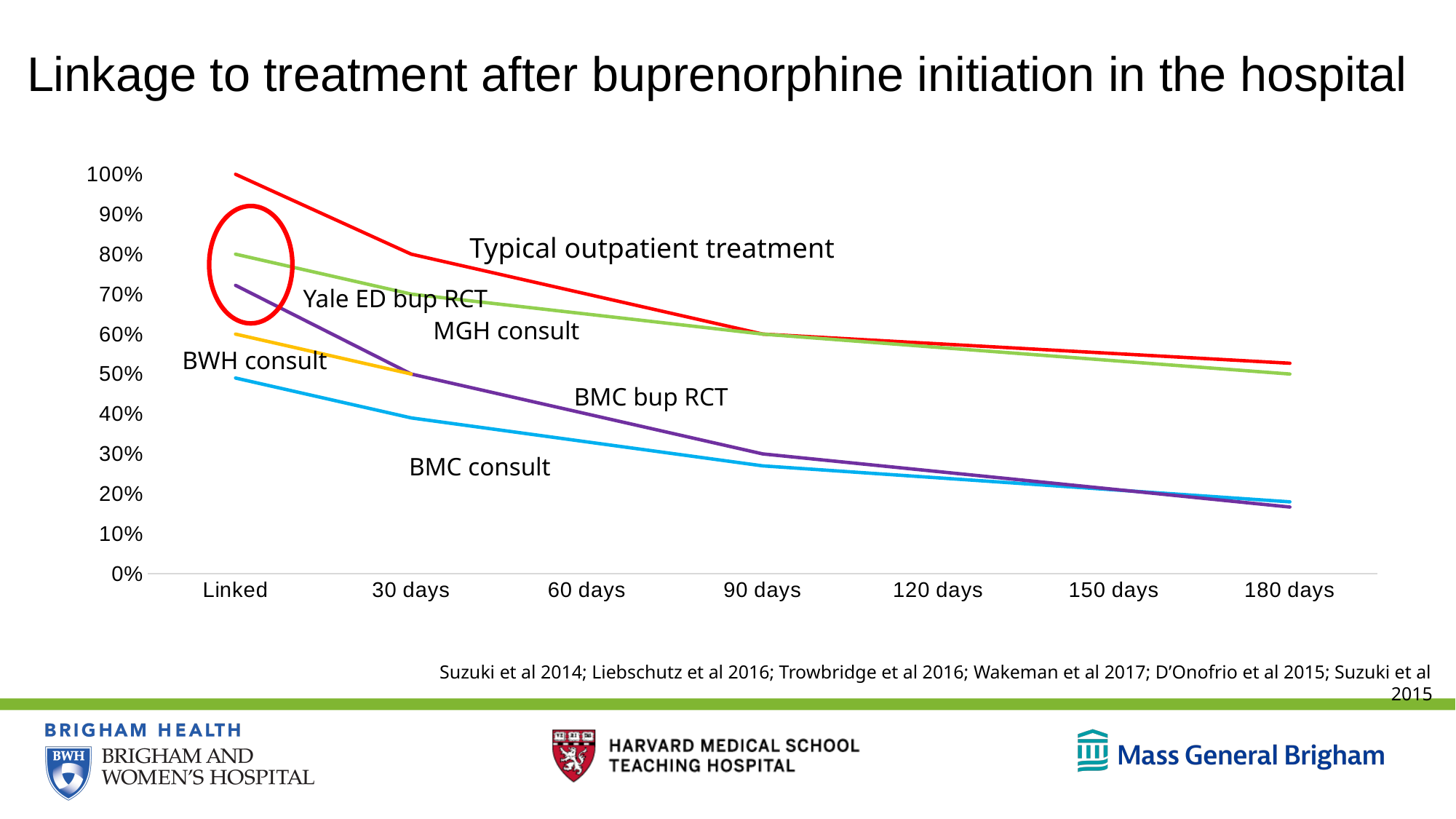
What kind of chart is shown on the slide? line chart What is the value for Typical outpatient treatment at the Linked point? 100% Which series has the lowest value at the Linked point? BMC consult Is the value for BMC bup RCT at 180 days greater or less than 20%? less What is the value for BWH consult at the Linked point? 60% How many time points are labelled on the x axis? 7 Is the value for BMC consult at 90 days greater or less than 30%? less What is the title of the slide? Linkage to treatment after buprenorphine initiation in the hospital Do the values for Typical outpatient treatment rise or fall from Linked to 180 days? fall Which series has the highest value at the Linked point? Typical outpatient treatment At 180 days, which is larger: Typical outpatient treatment or BMC consult? Typical outpatient treatment Is the value for Typical outpatient treatment at 180 days greater or less than 50%? greater